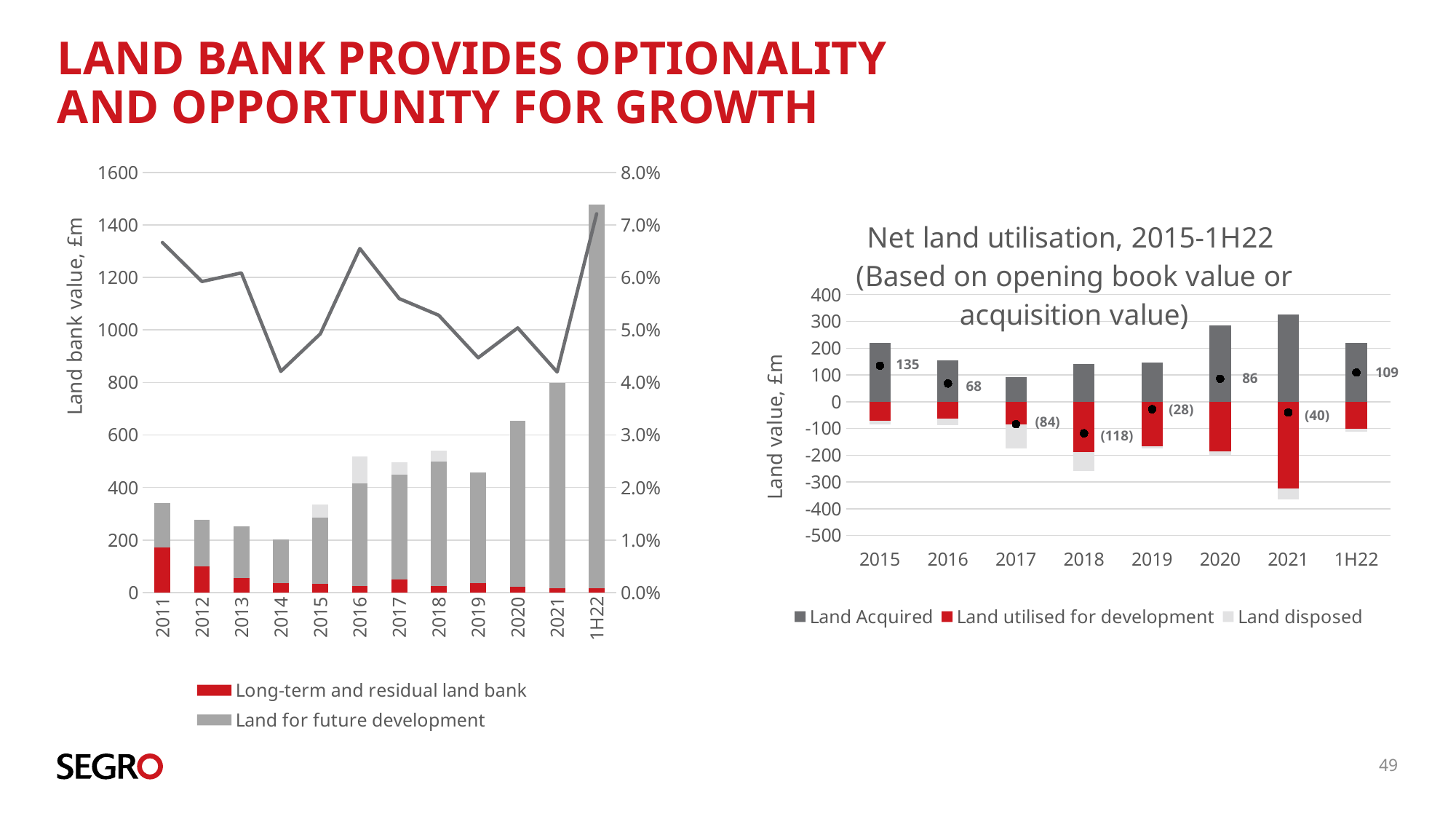
In the 'Net land utilisation, 2015-1H22' chart, what is the net value labelled for 2015? 135 In the 'Net land utilisation, 2015-1H22' chart, which year has the highest labelled net value? 2015 In the left-hand land bank value chart, how many periods are shown on the x axis? 12 How many periods are shown on the x axis of the 'Net land utilisation, 2015-1H22' chart? 8 In the left-hand land bank value chart, is the total bar for 2014 greater or less than 400? less In the 'Net land utilisation, 2015-1H22' chart, what is the difference between the labelled net values for 2015 and 1H22? 26 In the 'Net land utilisation, 2015-1H22' chart, what is the net value labelled for 2018? (118) In the 'Net land utilisation, 2015-1H22' chart, what is the net value labelled for 1H22? 109 In the 'Net land utilisation, 2015-1H22' chart, which year has the lowest labelled net value? 2018 How many series does the legend of the 'Net land utilisation, 2015-1H22' chart list? 3 In the 'Net land utilisation, 2015-1H22' chart, is the Land Acquired value for 2021 greater or less than 300? greater In the left-hand land bank value chart, which period has the tallest stacked bar? 1H22